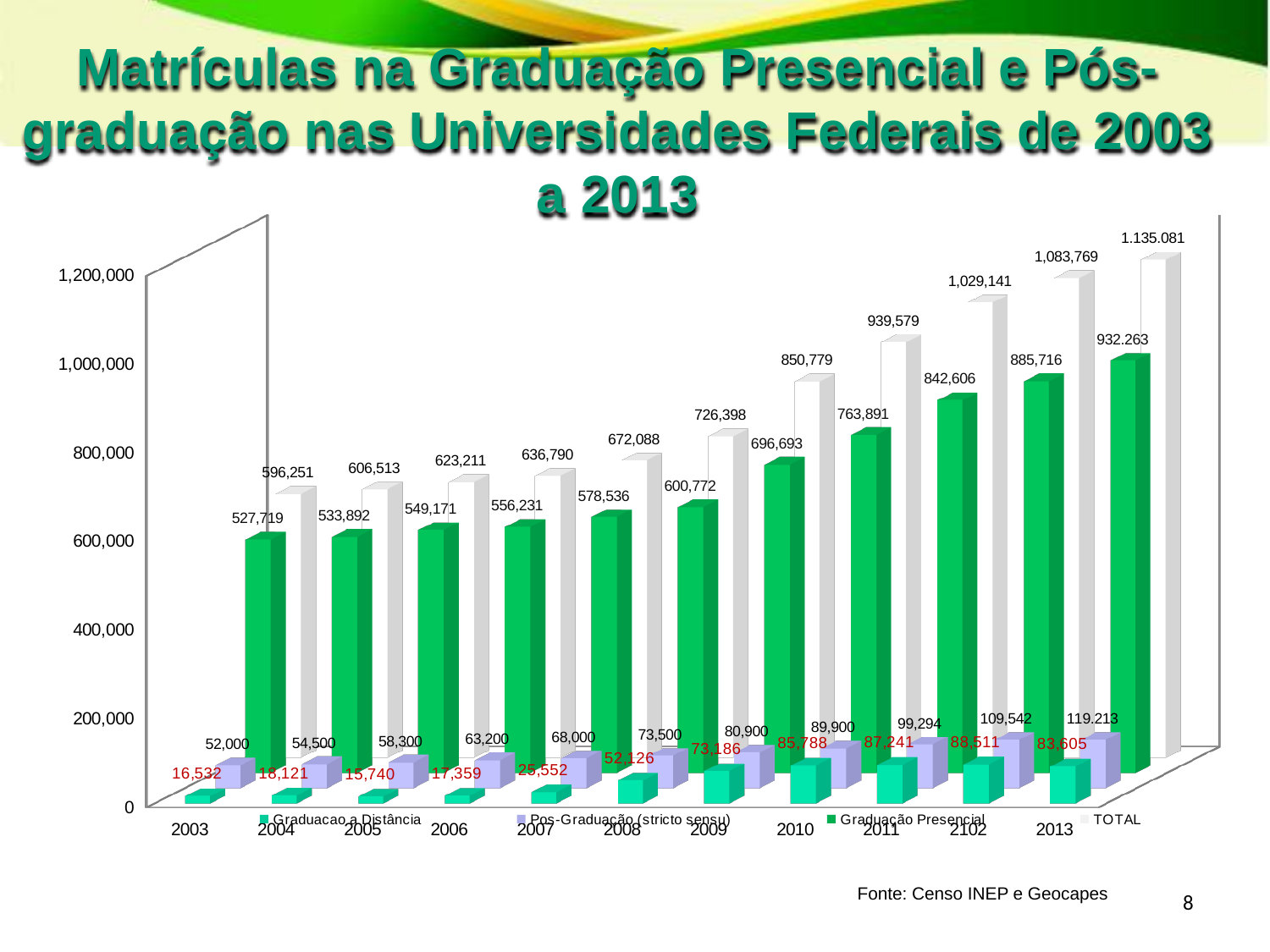
What is the value for Pos-Graduação (stricto sensu) in 2008? 73,500 Is the value for Graduação Presencial in 2009 greater or less than 600,000? greater In 2010, which is larger: Pos-Graduação (stricto sensu) or Graduacao a Distância? Pos-Graduação (stricto sensu) In which year is the TOTAL highest? 2013 Does the TOTAL series rise or fall from 2003 to 2013? rise In which year is the value for Graduacao a Distância lowest? 2005 How many series does the legend list? 4 What kind of chart is shown on the slide? bar chart How many years are shown on the x axis? 11 What is the difference between the Graduação Presencial values for 2010 and 2009? 67,198 What is the value for Graduação Presencial in 2003? 527,719 What is the TOTAL value shown for 2013? 1.135.081